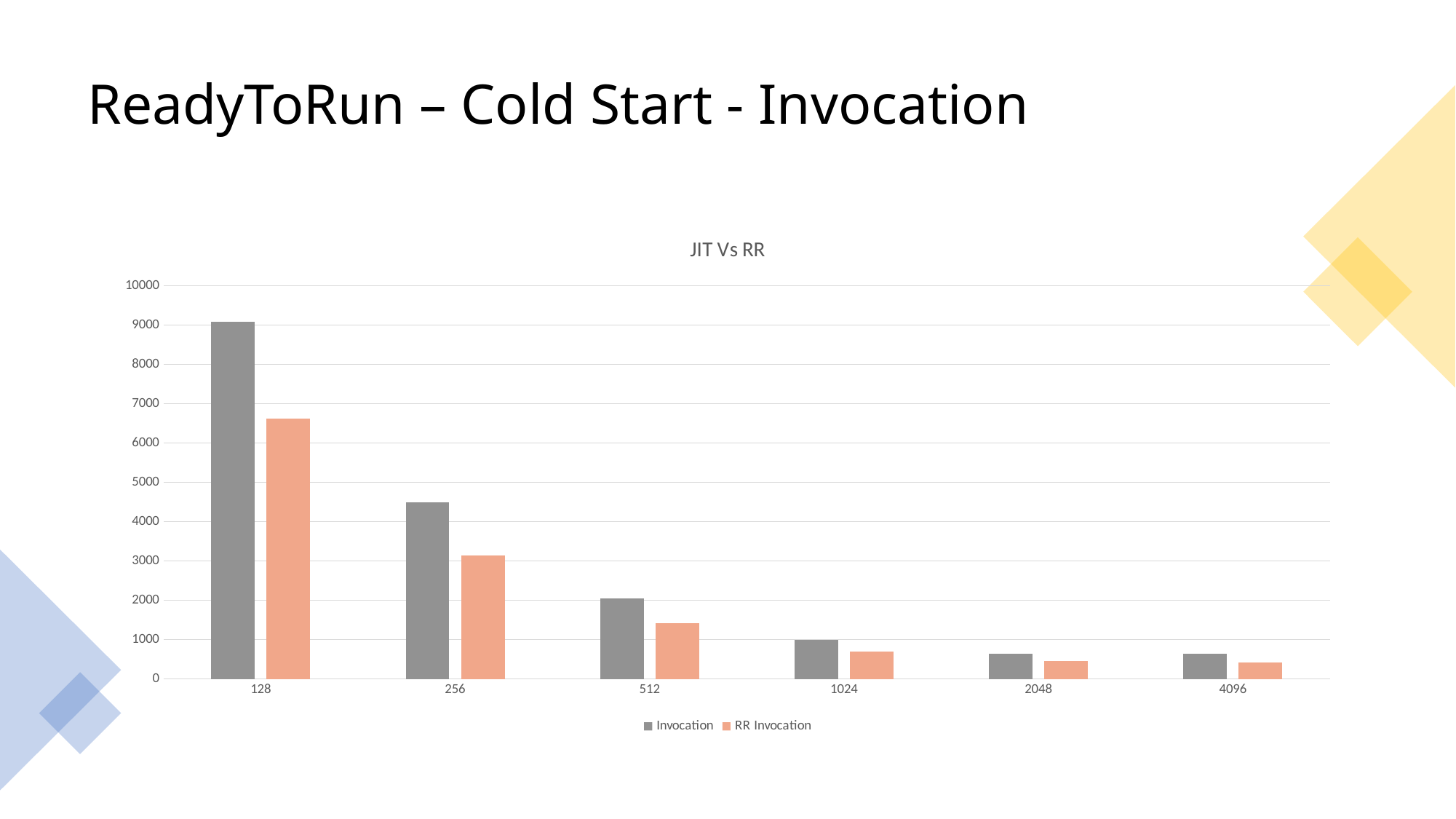
Is the RR Invocation value for 512 greater or less than 1000? greater What kind of chart is shown on the slide? bar chart Is the Invocation value for 128 greater or less than 8000? greater How many categories are shown on the x axis? 6 How many series does the legend list? 2 Is the Invocation value for 256 greater or less than 5000? less What is the title of the chart? JIT Vs RR Which category has the highest Invocation value? 128 Do the Invocation values rise or fall as you move from 128 to 4096 along the x axis? fall At 256, which is larger: Invocation or RR Invocation? Invocation